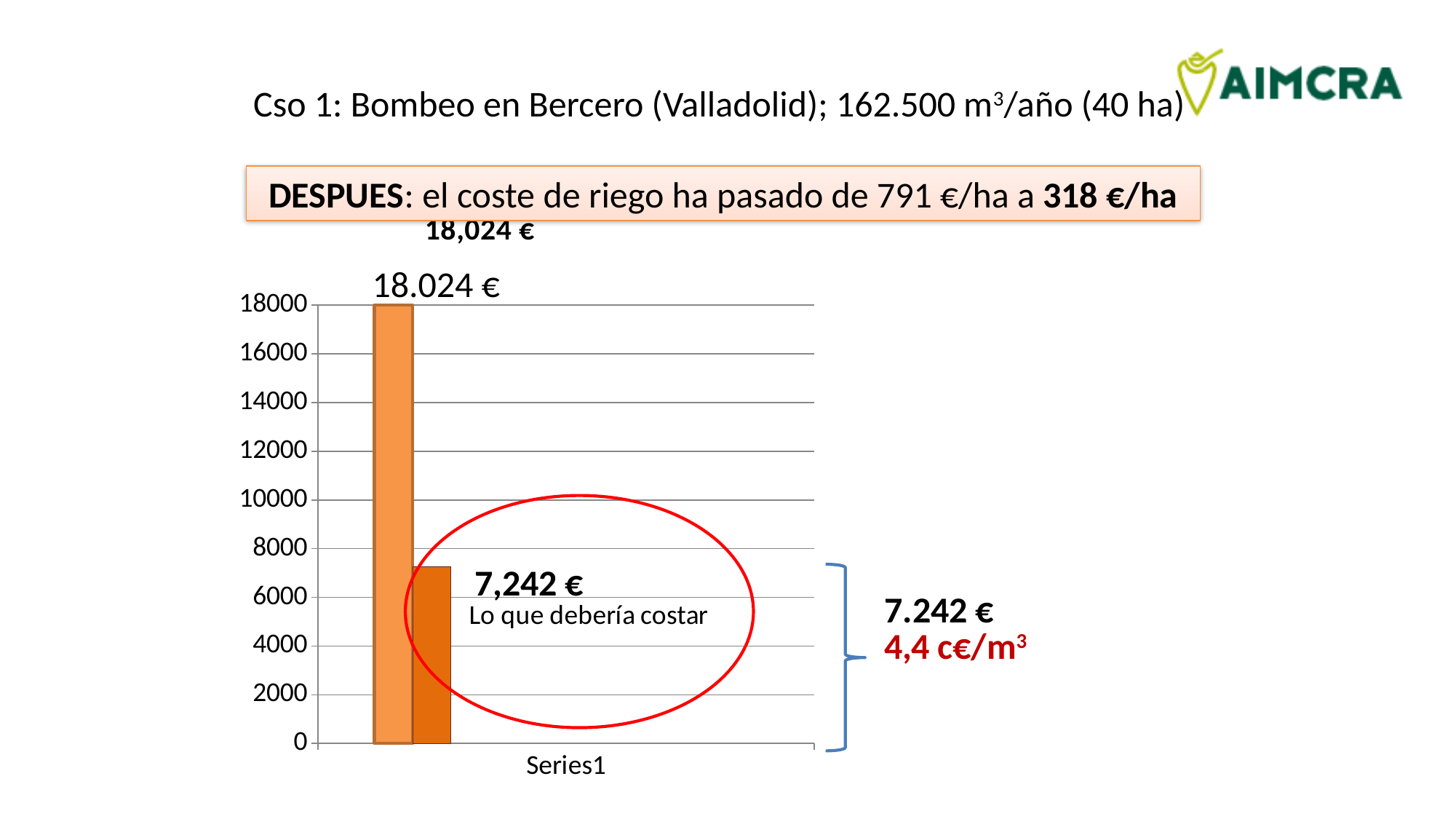
What text is written next to the 7,242 € label inside the red circle? Lo que debería costar What is the value labelled on the shorter, dark orange bar? 7,242 € What is the difference between the two bar values, 18,024 € and 7,242 €? 10,782 € What is the highest value plotted in the chart? 18,024 € How many bars are plotted in the chart? 2 What is the lowest value plotted in the chart? 7,242 € What is the value labelled on the taller, light orange bar? 18,024 € What is the category label shown on the x axis? Series1 What type of chart is shown on the slide? bar chart Which bar is taller, the light orange bar or the dark orange bar? the light orange bar Is the value of the light orange bar greater or less than 16000? greater Is the value of the dark orange bar greater or less than 8000? less